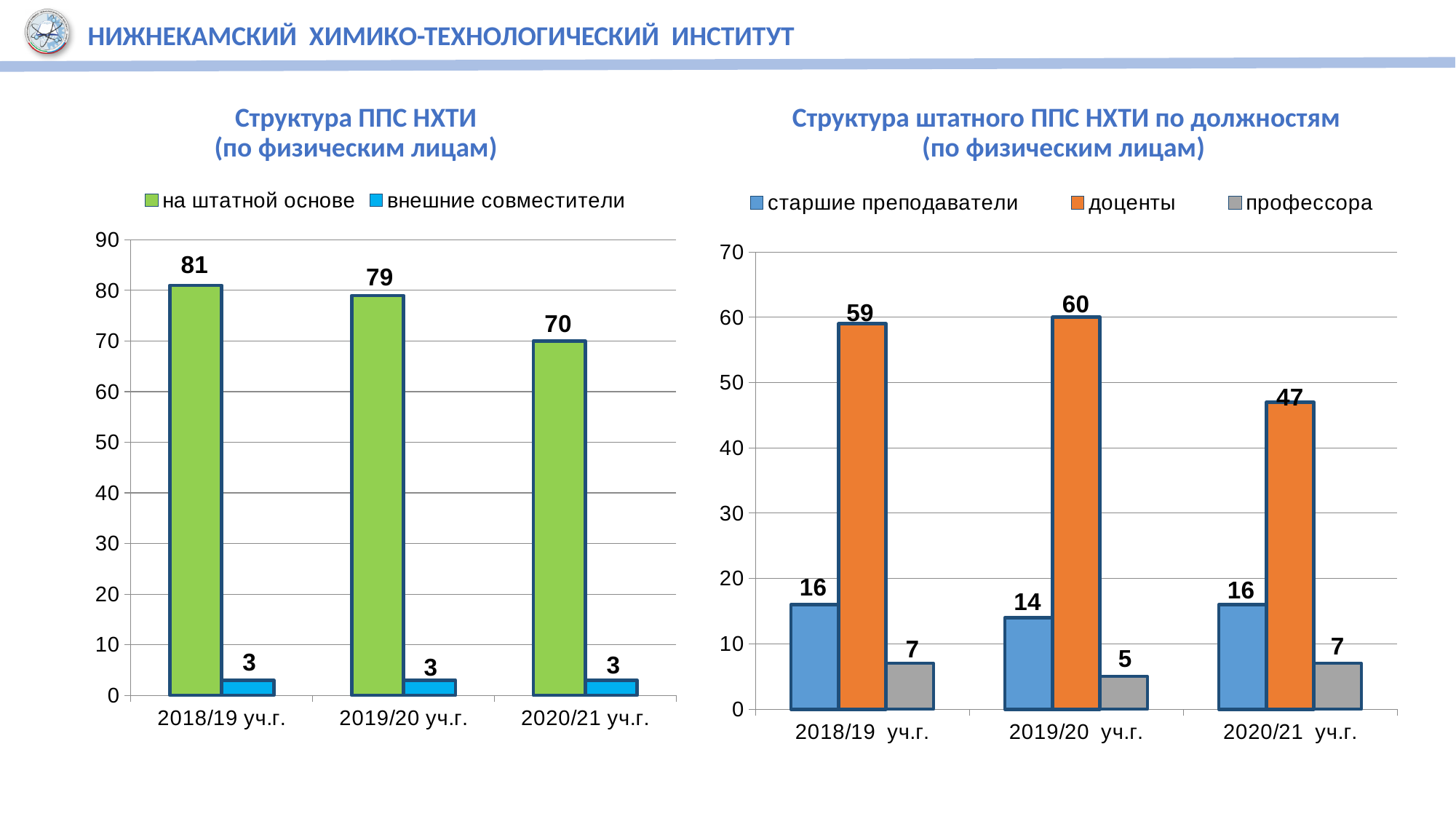
In the right chart 'Структура штатного ППС НХТИ по должностям (по физическим лицам)', what is the value for 'профессора' in 2019/20 уч.г.? 5 In the right chart 'Структура штатного ППС НХТИ по должностям (по физическим лицам)', what is the difference between 'доценты' in 2019/20 уч.г. and 2020/21 уч.г.? 13 In the right chart 'Структура штатного ППС НХТИ по должностям (по физическим лицам)', which is larger in 2018/19 уч.г.: 'старшие преподаватели' or 'профессора'? старшие преподаватели In the left chart 'Структура ППС НХТИ (по физическим лицам)', what is the value for 'на штатной основе' in 2018/19 уч.г.? 81 In the left chart 'Структура ППС НХТИ (по физическим лицам)', what is the difference between the 'на штатной основе' values for 2018/19 уч.г. and 2020/21 уч.г.? 11 In the right chart 'Структура штатного ППС НХТИ по должностям (по физическим лицам)', what is the value for 'доценты' in 2019/20 уч.г.? 60 In the left chart 'Структура ППС НХТИ (по физическим лицам)', how many series does the legend list? 2 In the left chart 'Структура ППС НХТИ (по физическим лицам)', what is the value for 'внешние совместители' in 2020/21 уч.г.? 3 In the left chart 'Структура ППС НХТИ (по физическим лицам)', do the 'на штатной основе' values rise or fall from 2018/19 to 2020/21? fall In the left chart 'Структура ППС НХТИ (по физическим лицам)', which year has the lowest value for 'на штатной основе'? 2020/21 уч.г. In the right chart 'Структура штатного ППС НХТИ по должностям (по физическим лицам)', which year has the lowest value for 'доценты'? 2020/21 уч.г. What type of chart is the right chart 'Структура штатного ППС НХТИ по должностям (по физическим лицам)'? bar chart